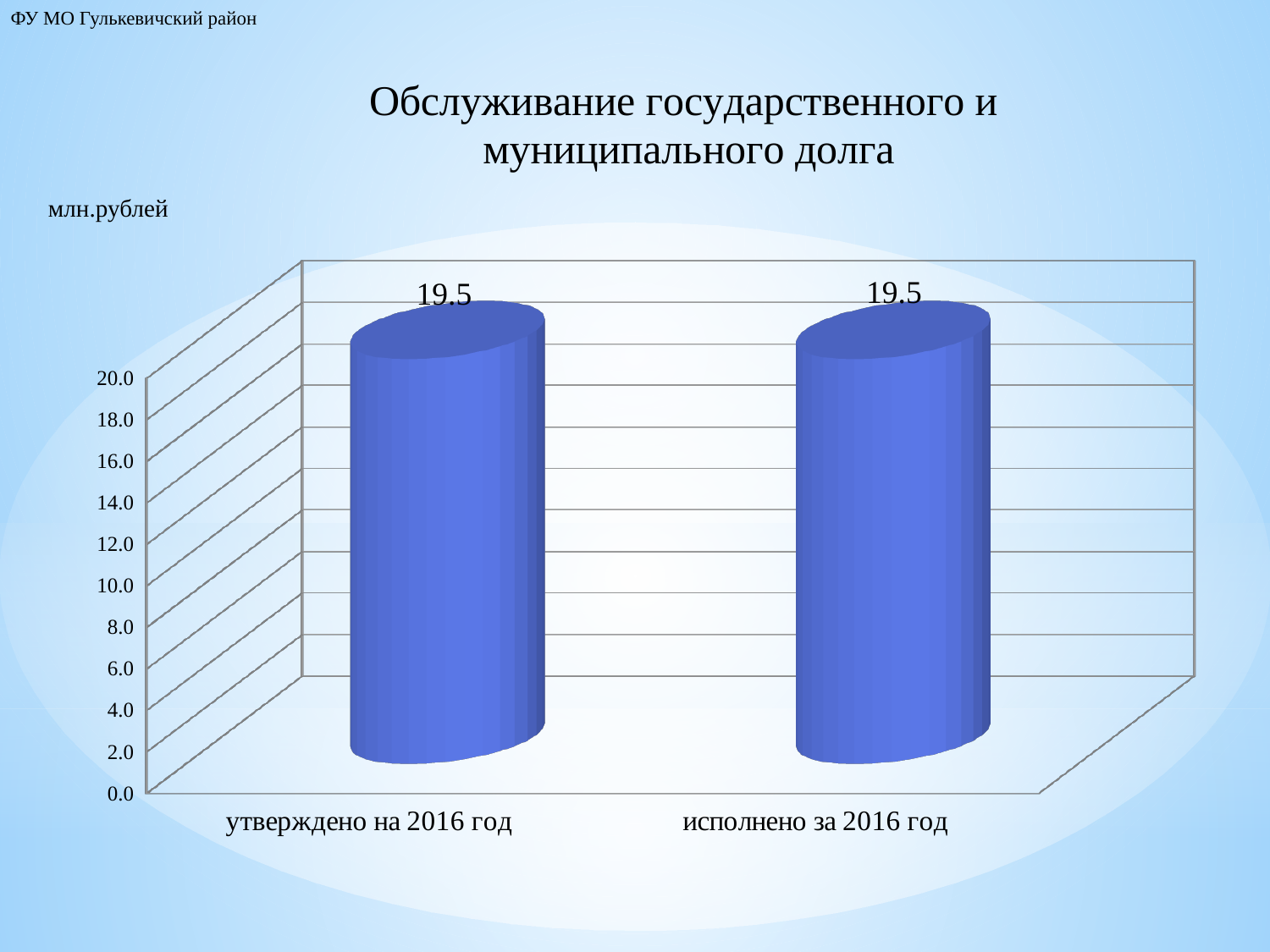
What is the value for «утверждено на 2016 год»? 19.5 Is the value for «исполнено за 2016 год» greater or less than 10.0? greater Is the value for «утверждено на 2016 год» greater or less than 18.0? greater In what units are the chart values given? млн.рублей What kind of chart is shown on the slide? bar chart Is the value for «исполнено за 2016 год» larger than, smaller than, or equal to the value for «утверждено на 2016 год»? equal Do the values rise, fall, or stay the same from «утверждено на 2016 год» to «исполнено за 2016 год»? stay the same What is the title of the chart? Обслуживание государственного и муниципального долга How many categories are shown on the chart? 2 What is the value for «исполнено за 2016 год»? 19.5 What is the difference between the values for «утверждено на 2016 год» and «исполнено за 2016 год»? 0.0